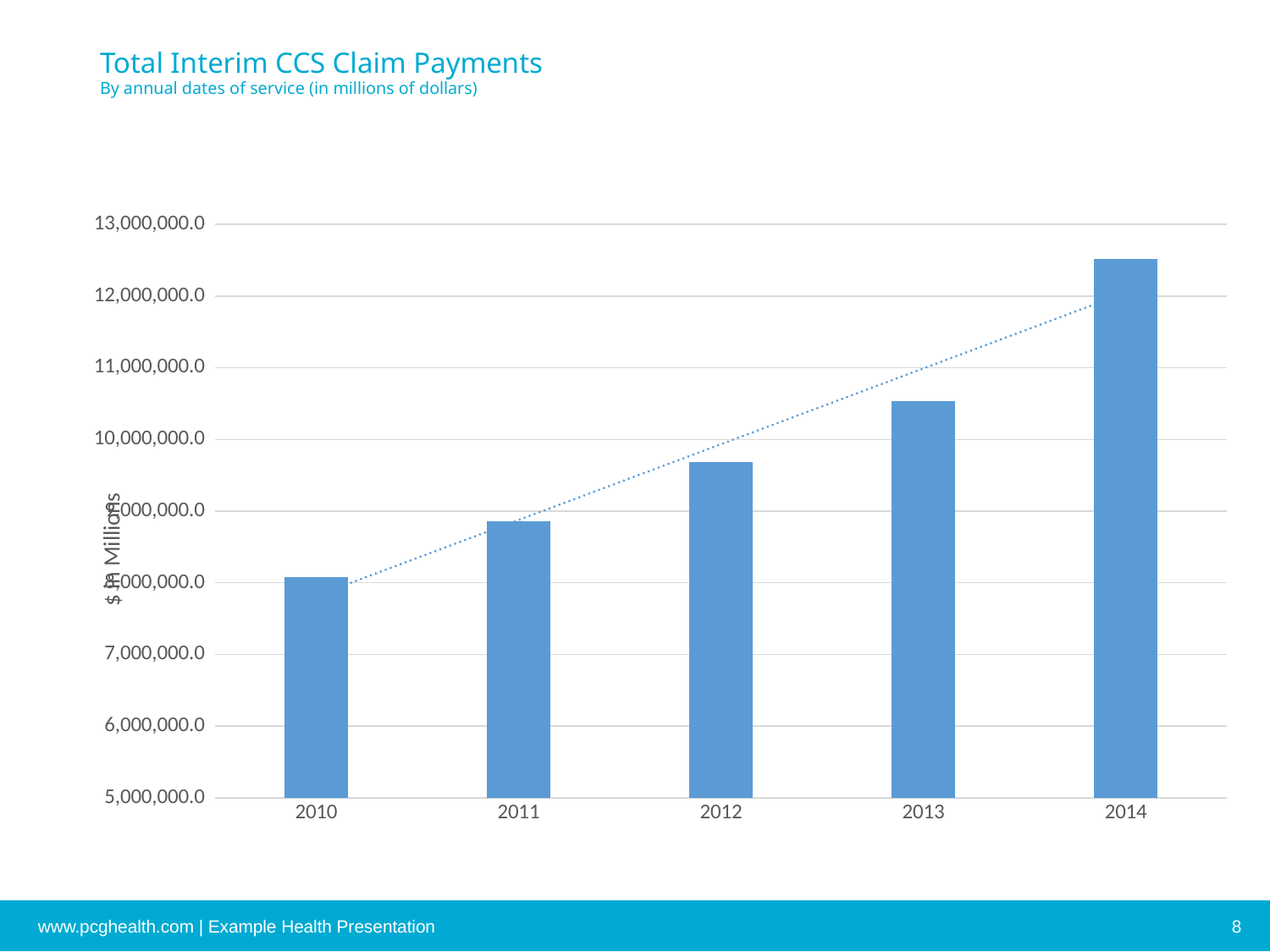
Do the claim payments rise or fall from 2010 to 2014? rise Is the value for 2014 greater or less than 12,000,000.0? greater Which year has the highest total interim CCS claim payments? 2014 Is the value for 2013 greater or less than 10,000,000.0? greater Is the value for 2011 greater or less than 9,000,000.0? less What is the title of the chart? Total Interim CCS Claim Payments Which year has larger claim payments, 2012 or 2013? 2013 How many years are plotted on the x axis of the chart? 5 What is the label on the vertical axis of the chart? $ in Millions What kind of chart is shown on the slide? bar chart Which year has the lowest total interim CCS claim payments? 2010